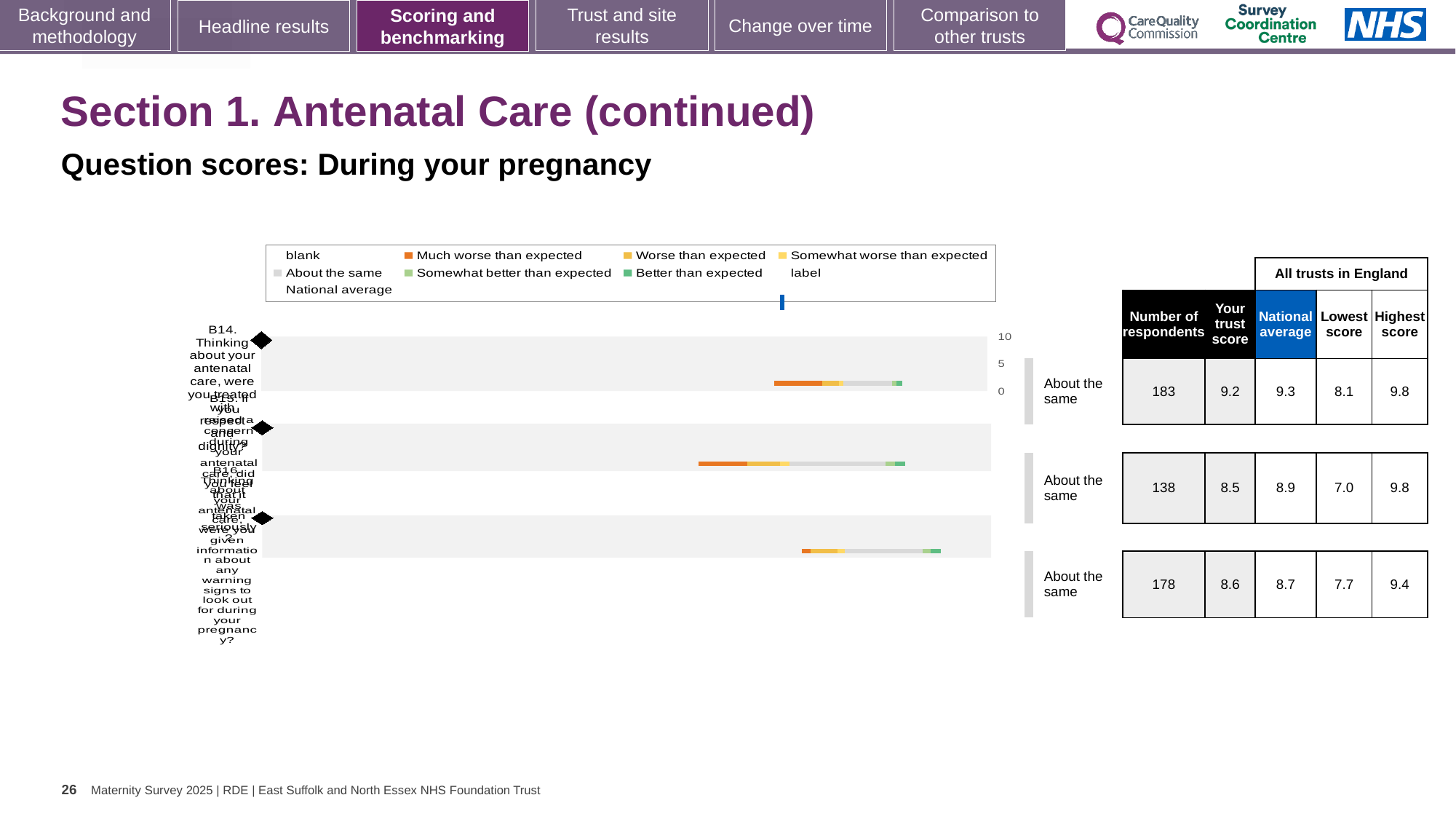
In the table beside the chart, how many respondents are listed for the first row (B14)? 183 Which row has the highest 'Your trust score' in the table beside the chart? The first row (B14), 9.2 What benchmark category is shown next to each of the three bars? About the same What colour does the legend use for 'Much worse than expected'? Orange In the table beside the chart, what is the national average for the second row? 8.9 How many question rows (bars) does the chart show? 3 Is the trust score for the first row or the third row larger? The first row (9.2) Which row has the lowest 'Your trust score' in the table beside the chart? The second row, 8.5 For the second row, how much higher is the national average than the trust score? 0.4 In the table beside the chart, what is the highest score for the third row? 9.4 What kind of chart is shown on the slide? Bar chart In the table beside the chart, what is the 'Your trust score' for the first row (B14, treated with respect and dignity)? 9.2